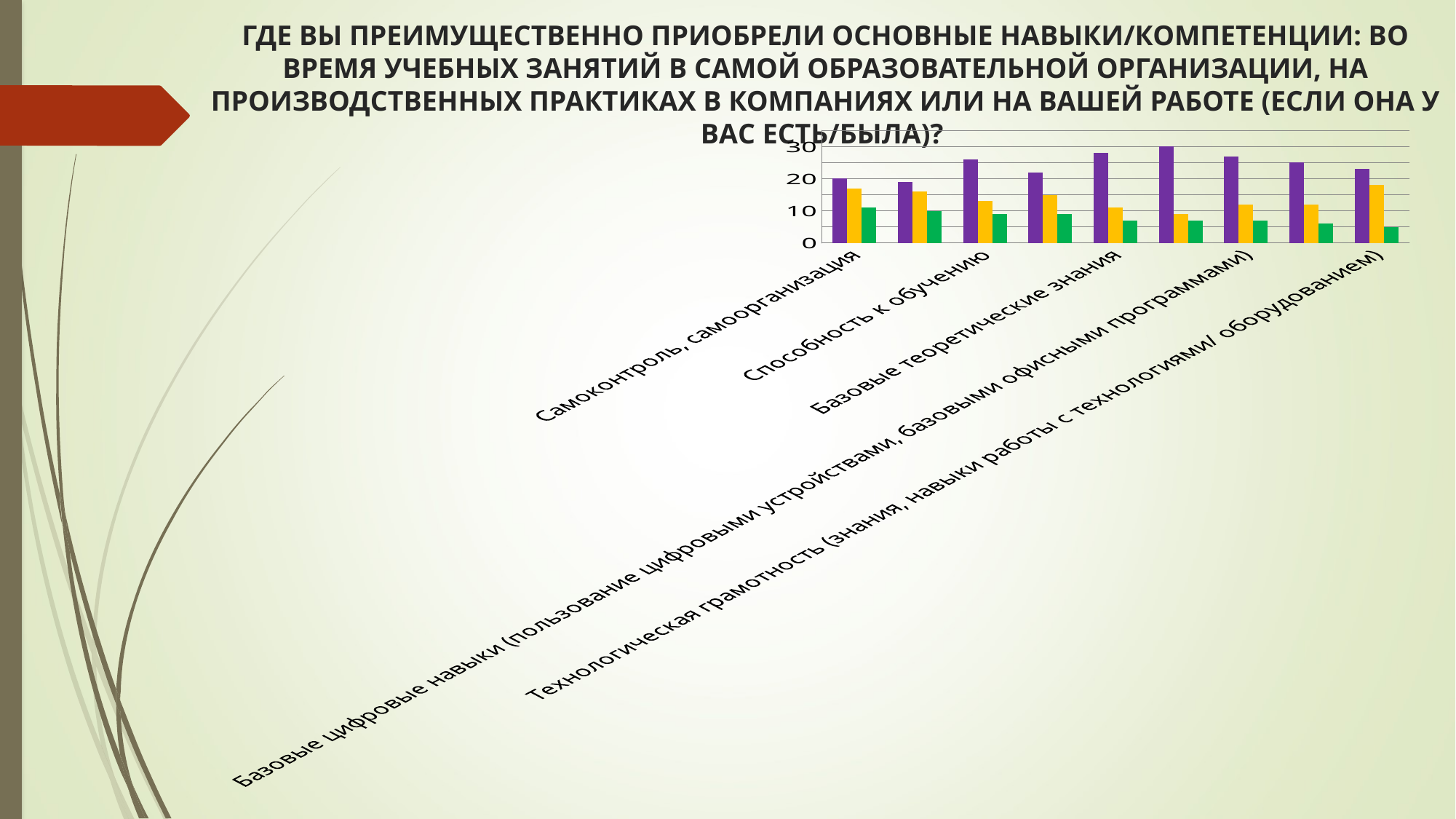
Is the value of the green bar for 'Технологическая грамотность' greater or less than 10? less What three colours are used for the bars in the chart? purple, yellow and green For 'Самоконтроль, самоорганизация', which bar is taller: the purple bar or the green bar? the purple bar Is the value of the green bar for 'Базовые цифровые навыки' greater or less than 10? less Is the value of the purple bar for 'Базовые теоретические знания' greater or less than 20? greater For 'Технологическая грамотность', which bar is taller: the yellow bar or the green bar? the yellow bar What is the highest value shown on the vertical axis of the chart? 30 How many groups of bars (categories) are plotted in the chart? 9 What kind of chart is shown on the slide? bar chart How many bars are shown for each category in the chart? 3